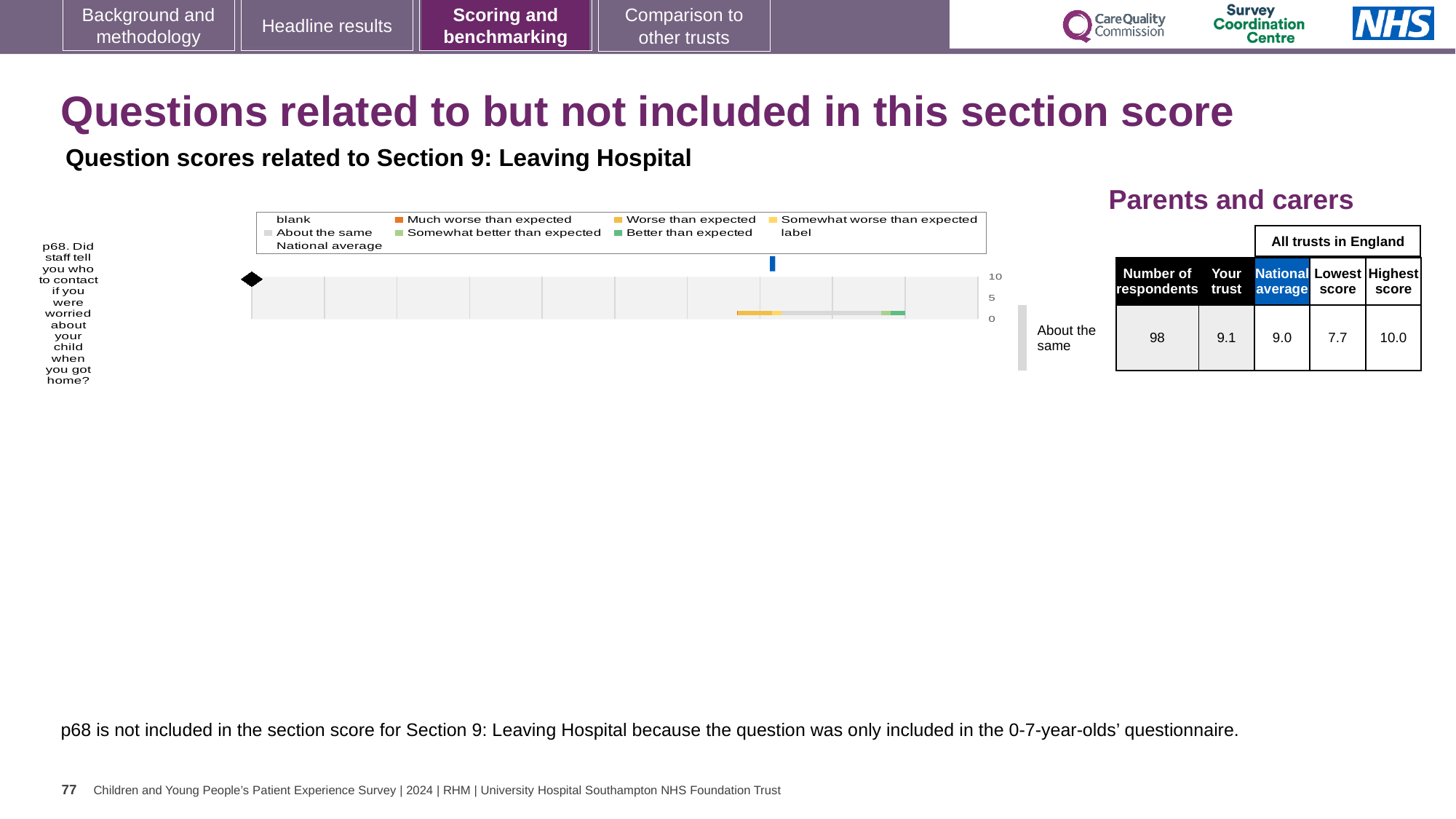
What is the lowest score among all trusts in England for p68? 7.7 Is the 'Your trust' score for p68 greater or less than 5 on the chart axis? greater Which is larger for p68, the 'Your trust' score or the national average? Your trust Which question is plotted in the chart? p68. Did staff tell you who to contact if you were worried about your child when you got home? What is the 'Your trust' score for p68? 9.1 What is the difference between the highest score and the lowest score for p68? 2.3 What is the highest score among all trusts in England for p68? 10.0 How many respondents answered p68? 98 What is the national average score for p68? 9.0 How many questions (categories) are plotted in the chart? 1 What kind of chart is shown on the slide? bar chart What benchmark category is the trust's p68 result labelled as next to the chart? About the same